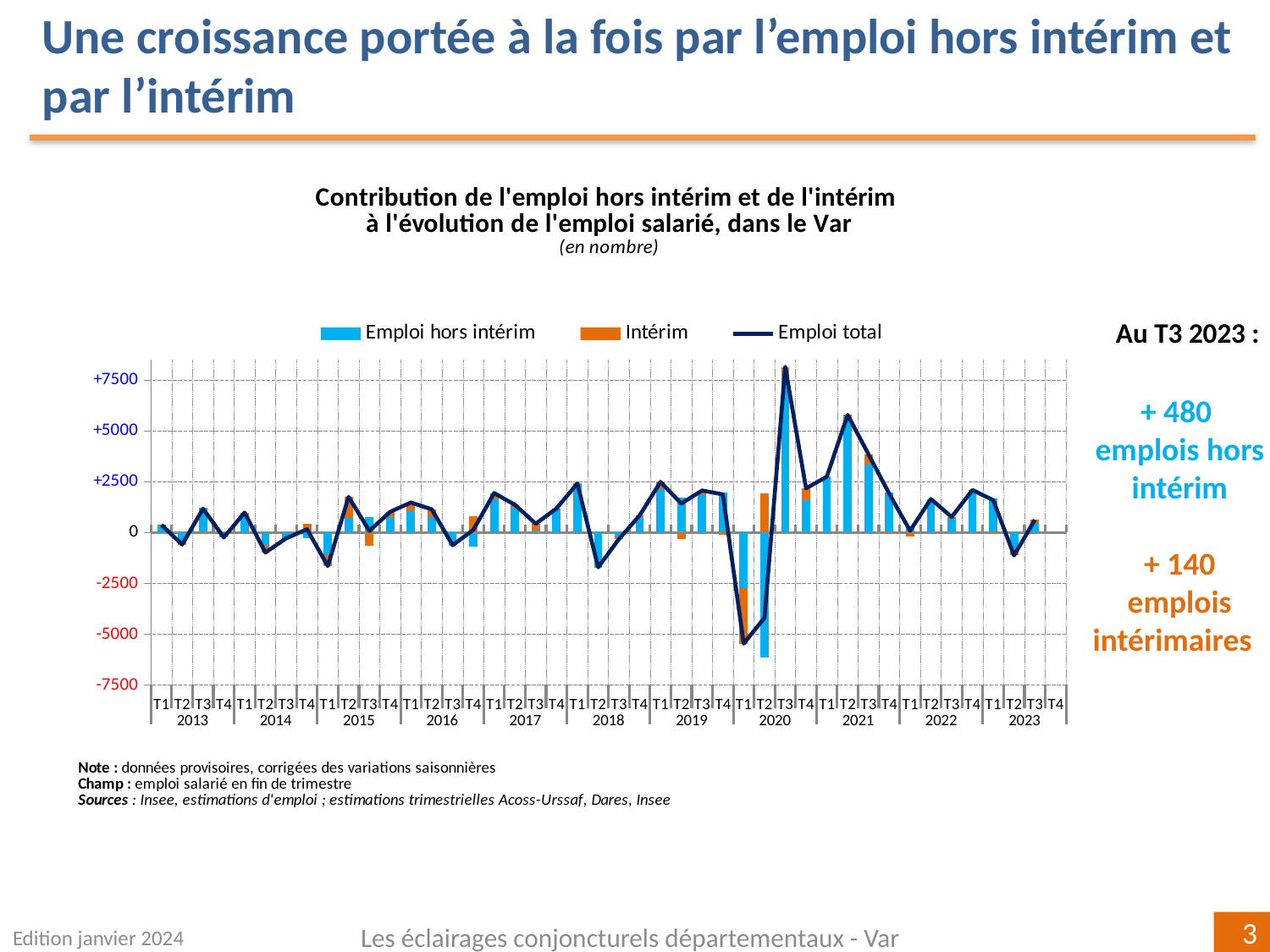
What colour are the Intérim bars? Orange What is the total of the two contributions (hors intérim and intérim) at T3 2023? + 620 Is the Emploi total value at T3 2020 greater or less than 5000? greater According to the slide, what is the contribution of emploi intérimaire at T3 2023? + 140 What kind of chart is shown on the slide? A combined bar and line chart Which series is drawn as a line rather than bars? Emploi total In which quarter does the Emploi total line reach its highest value? T3 2020 How many series does the chart legend list? 3 According to the slide, what is the contribution of emploi hors intérim at T3 2023? + 480 In which quarter does the Emploi total line reach its lowest value? T1 2020 Is the Emploi hors intérim value at T2 2020 greater or less than -5000? less Which is larger, the Emploi total value at T3 2020 or at T2 2021? T3 2020